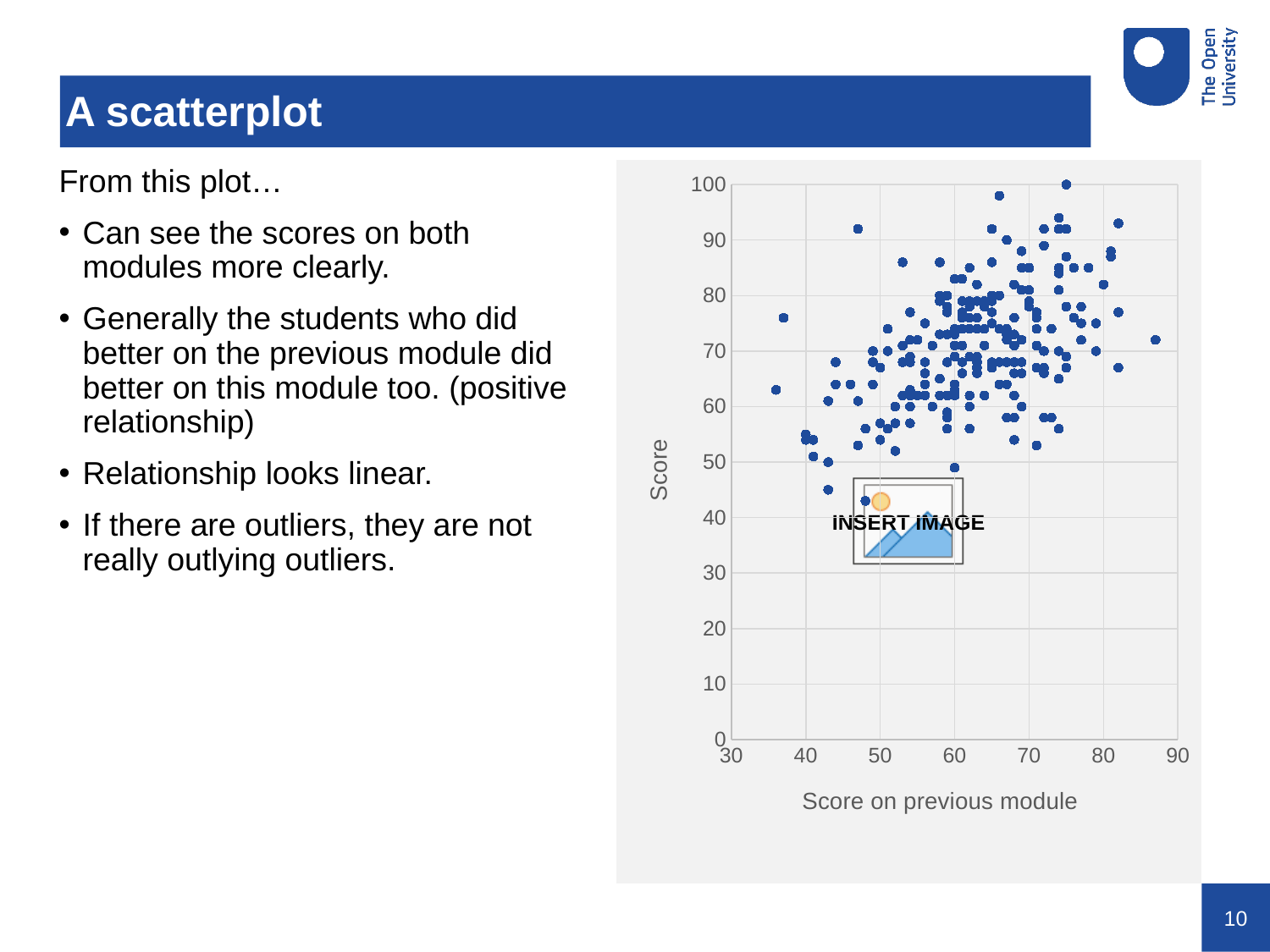
What is the title of the horizontal axis of the chart? Score on previous module Is the lowest Score on previous module plotted on the chart greater or less than 40? less Is the highest Score plotted on the chart greater or less than 90? greater Is the lowest Score plotted on the chart greater or less than 50? less Do the Score values generally rise or fall as Score on previous module increases? rise What is the title of the vertical axis of the chart? Score What kind of chart is shown on the slide? scatter plot